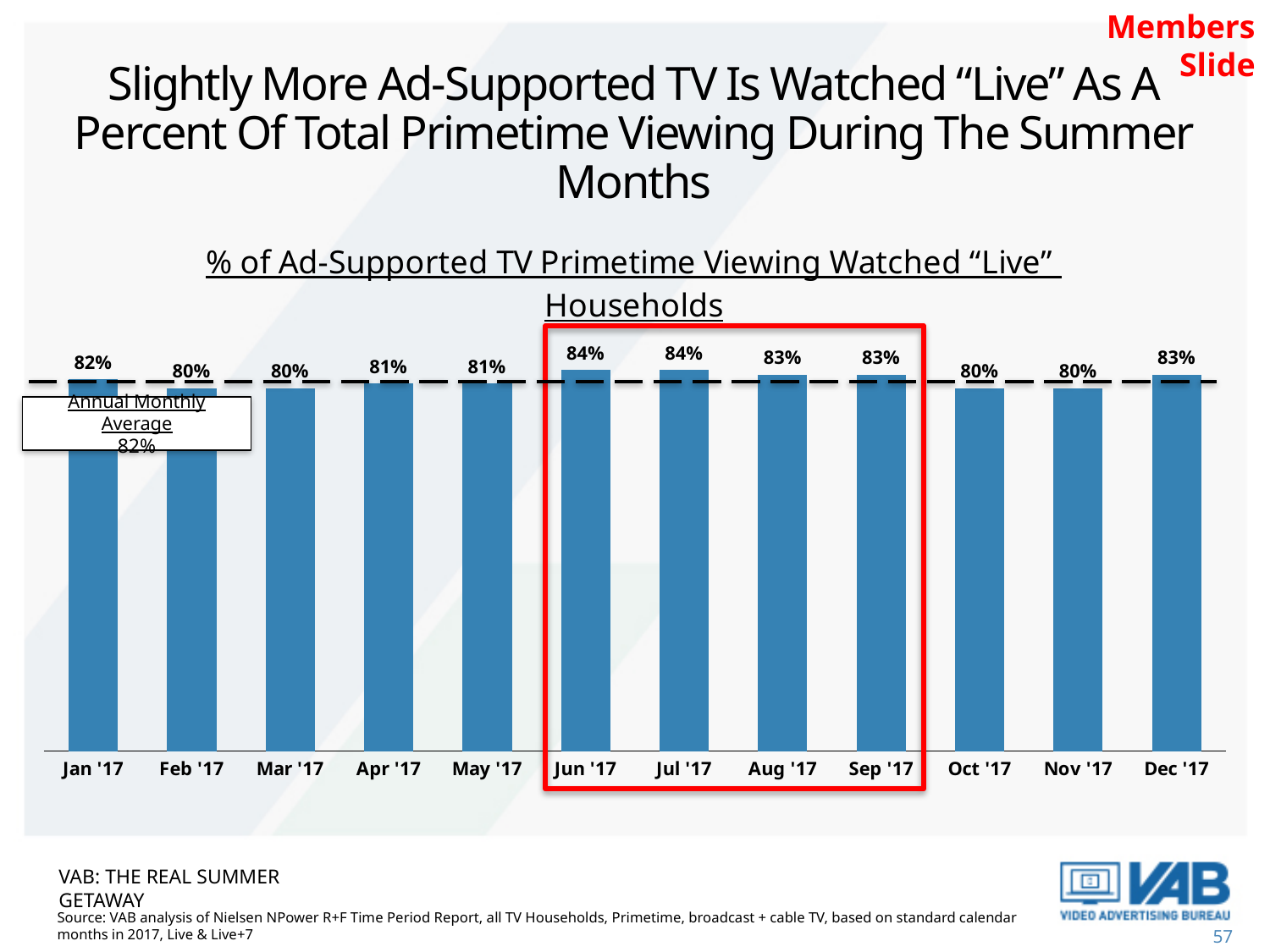
Which is larger, the value for Aug '17 or the value for Mar '17? Aug '17 What is the value for Feb '17? 80% What is the value for Jun '17? 84% What is the difference between the values for Jul '17 and Nov '17? 4% What is the value for Apr '17? 81% What is the lowest value shown on the chart? 80% How many months are shown on the x axis? 12 What is the annual monthly average shown by the dashed line? 82% What is the highest value shown on the chart? 84% What kind of chart is shown on the slide? Bar chart What is the value for Dec '17? 83% Do the values rise or fall from May '17 to Jun '17? Rise